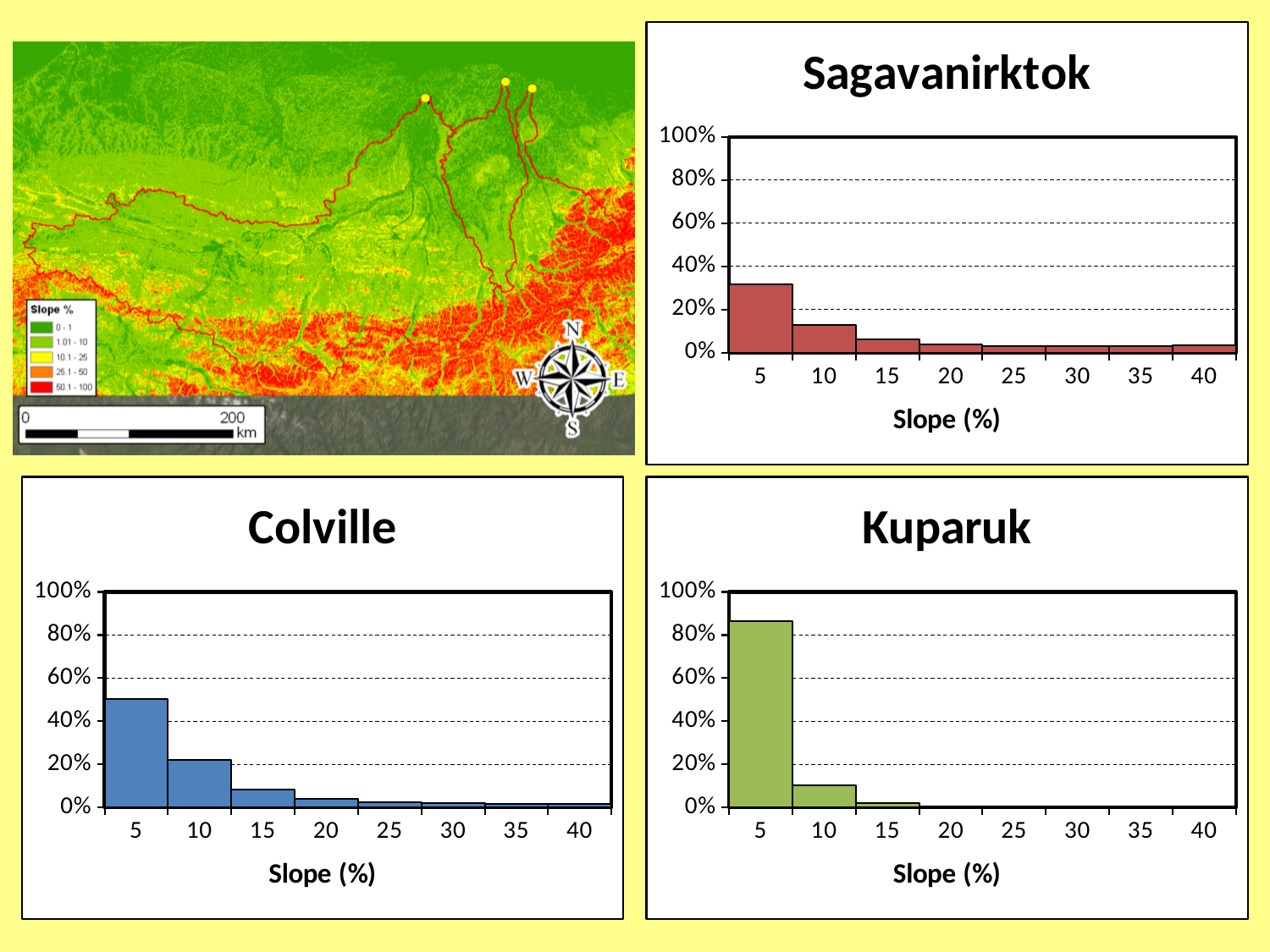
What is the x-axis title of the Colville chart? Slope (%) What kind of chart is the Sagavanirktok chart? bar chart In the Sagavanirktok chart, which is larger: the value for slope 5 or the value for slope 10? 5 How many slope categories are shown on the x axis of the Sagavanirktok chart? 8 In the Colville chart, is the value for slope 5 greater or less than 40%? greater Which is larger: the value for slope 5 in the Kuparuk chart or the value for slope 5 in the Colville chart? Kuparuk In the Sagavanirktok chart, is the value for slope 5 greater or less than 40%? less In the Sagavanirktok chart, is the value for slope 10 greater or less than 20%? less In the Kuparuk chart, which slope category has the highest value? 5 In the Colville chart, do the values rise or fall as slope increases along the x axis? fall What colour are the bars in the Colville chart? blue